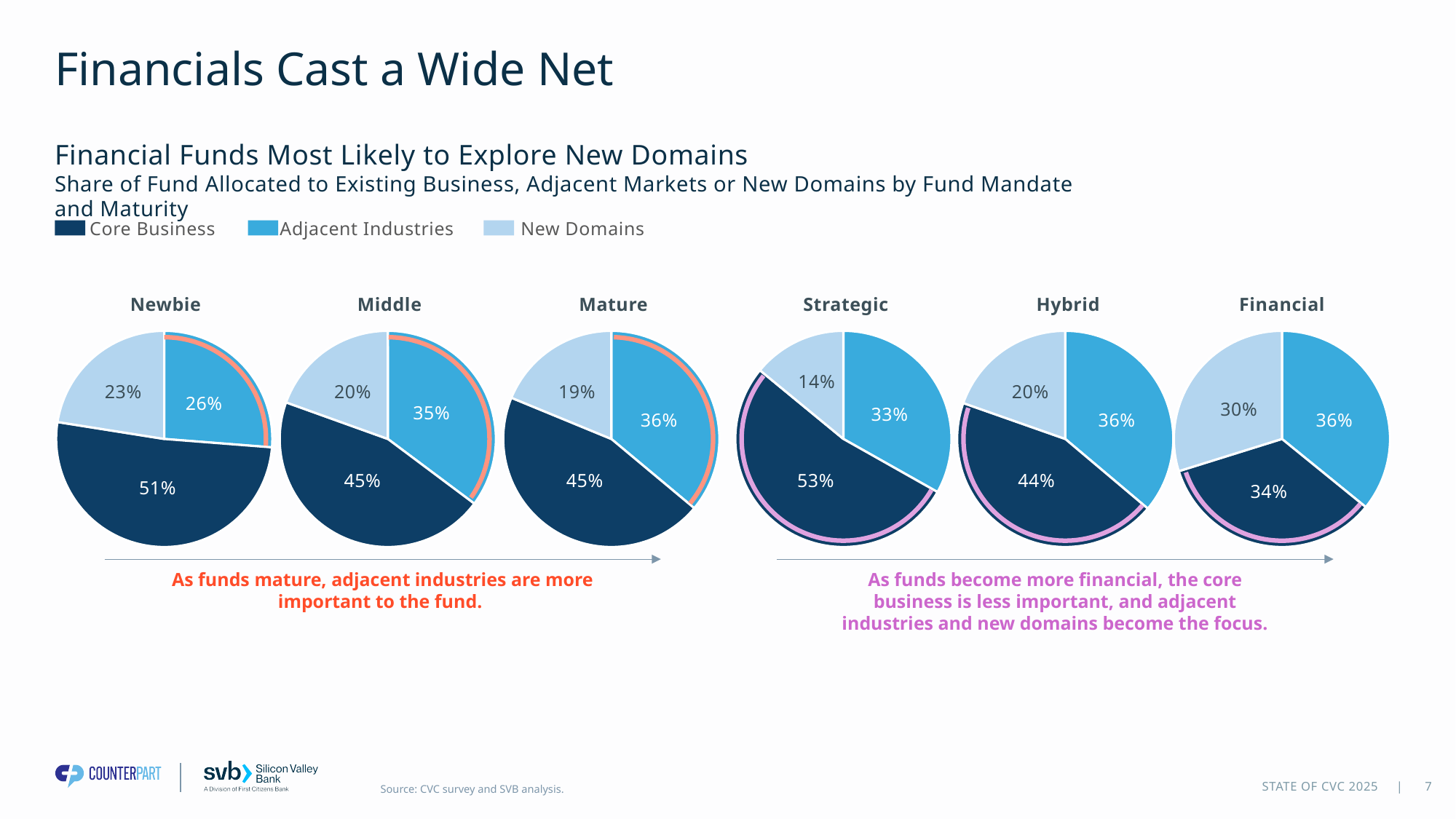
What is the difference between the Core Business share in the Strategic pie chart and the Core Business share in the Financial pie chart? 19 percentage points Which is larger: the Adjacent Industries share in the Newbie pie chart or in the Mature pie chart? Mature In the Strategic pie chart, which slice is the smallest? New Domains In the Hybrid pie chart, which slice is the largest? Core Business In the Financial pie chart, what share is allocated to New Domains? 30% How many pie charts are shown on the slide? 6 Across the Newbie, Middle and Mature pie charts, does the Adjacent Industries share rise or fall as funds mature? Rise How many categories does the legend list? 3 Which legend entry is shown in the darkest blue colour? Core Business What type of chart is used on this slide? Pie chart In the Newbie pie chart, what share is allocated to Core Business? 51% In the Strategic pie chart, what share is allocated to Adjacent Industries? 33%